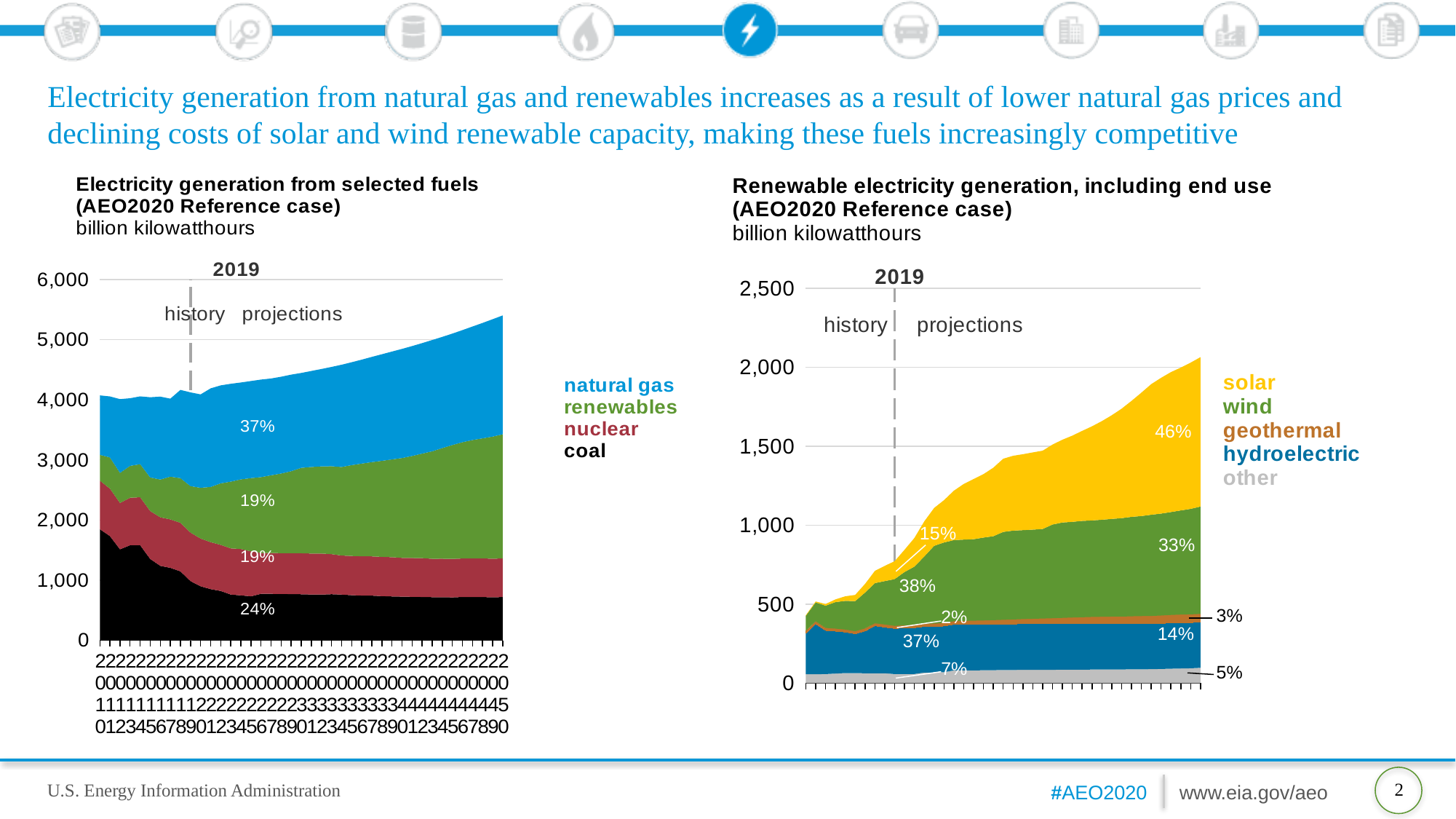
In the right chart, 'Renewable electricity generation, including end use', what percentage label is shown for hydroelectric at the right end of the projection period? 14% In the right chart, 'Renewable electricity generation, including end use', does total renewable generation rise or fall over the projection period? rise How many series does the legend of the left chart, 'Electricity generation from selected fuels', list? 4 What kind of chart is the left chart, 'Electricity generation from selected fuels'? stacked area chart In the right chart, 'Renewable electricity generation, including end use', what percentage label is shown for solar at the right end of the projection period? 46% In the left chart, 'Electricity generation from selected fuels', what percentage label is shown on the coal area? 24% In the right chart, 'Renewable electricity generation, including end use', what percentage label is shown for wind near the 2019 line? 38% In the left chart, 'Electricity generation from selected fuels', is the total generation at the end of the projection period greater or less than 5,000 billion kilowatthours? greater How many series does the legend of the right chart, 'Renewable electricity generation, including end use', list? 5 What unit is used on the y axis of both charts? billion kilowatthours In the left chart, 'Electricity generation from selected fuels', what percentage label is shown on the natural gas area? 37% In the right chart, 'Renewable electricity generation, including end use', is the total renewable generation at the end of the projection period greater or less than 2,000 billion kilowatthours? greater